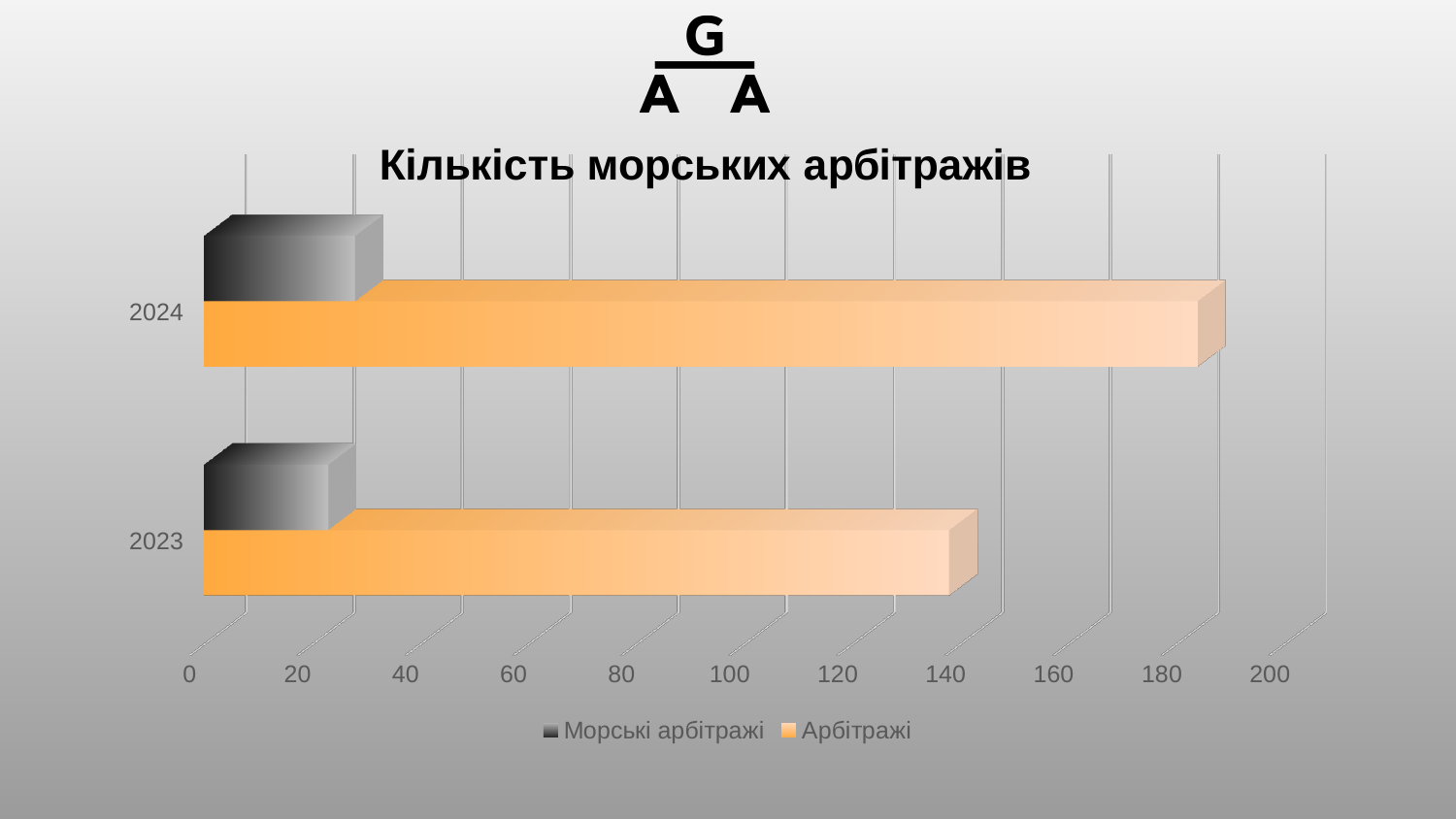
Is the value for Арбітражі in 2024 greater or less than 160? greater How many series does the legend list? 2 What is the title of the chart? Кількість морських арбітражів Does the value for Арбітражі rise or fall from 2023 to 2024? rise What kind of chart is shown on the slide? bar chart Is the value for Арбітражі in 2023 greater or less than 120? greater Which series is shown in orange? Арбітражі How many years (categories) are shown on the chart? 2 Is the value for Морські арбітражі in 2024 greater or less than 40? less Which year has the higher value for Арбітражі? 2024 In 2024, which series has the larger value, Морські арбітражі or Арбітражі? Арбітражі